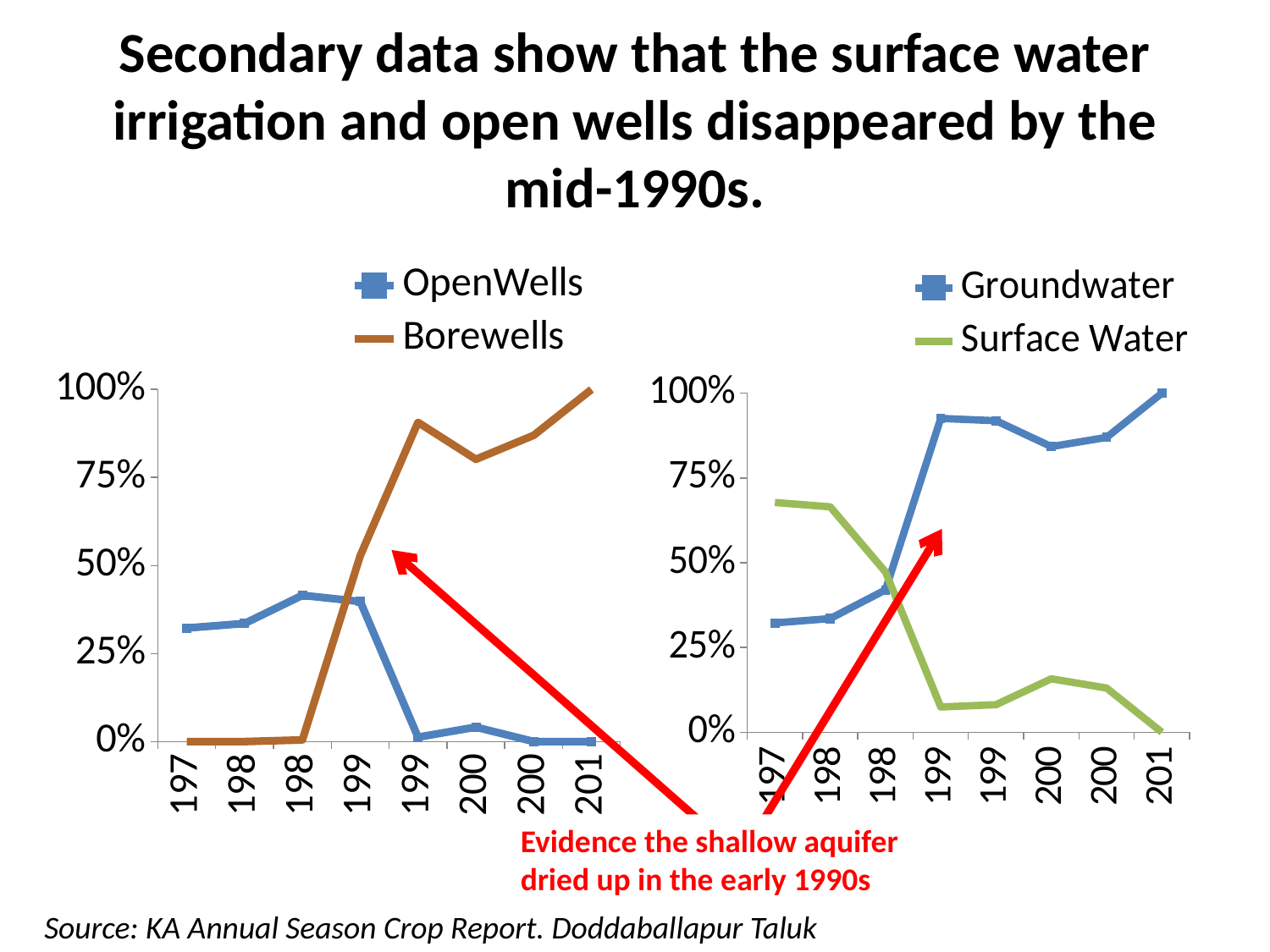
In the right chart, does the Surface Water series generally rise or fall along the x axis? fall What colour is the Borewells line in the left chart? brown How many series does the legend of the right chart list? 2 What kind of chart is the left chart (OpenWells and Borewells)? line chart In the left chart, how many points are plotted along the x axis for each series? 8 In the left chart, at the first point on the x axis, which series is higher: OpenWells or Borewells? OpenWells In the right chart, is the Surface Water value at the first point greater or less than 50%? greater In the left chart, does the Borewells series generally rise or fall along the x axis? rise In the right chart, at the last point on the x axis, which series is higher: Groundwater or Surface Water? Groundwater In the left chart, is the OpenWells value at the first point greater or less than 25%? greater In the left chart, what is the Borewells value at the last point on the x axis? 100% In the right chart, what is the Surface Water value at the last point on the x axis? 0%